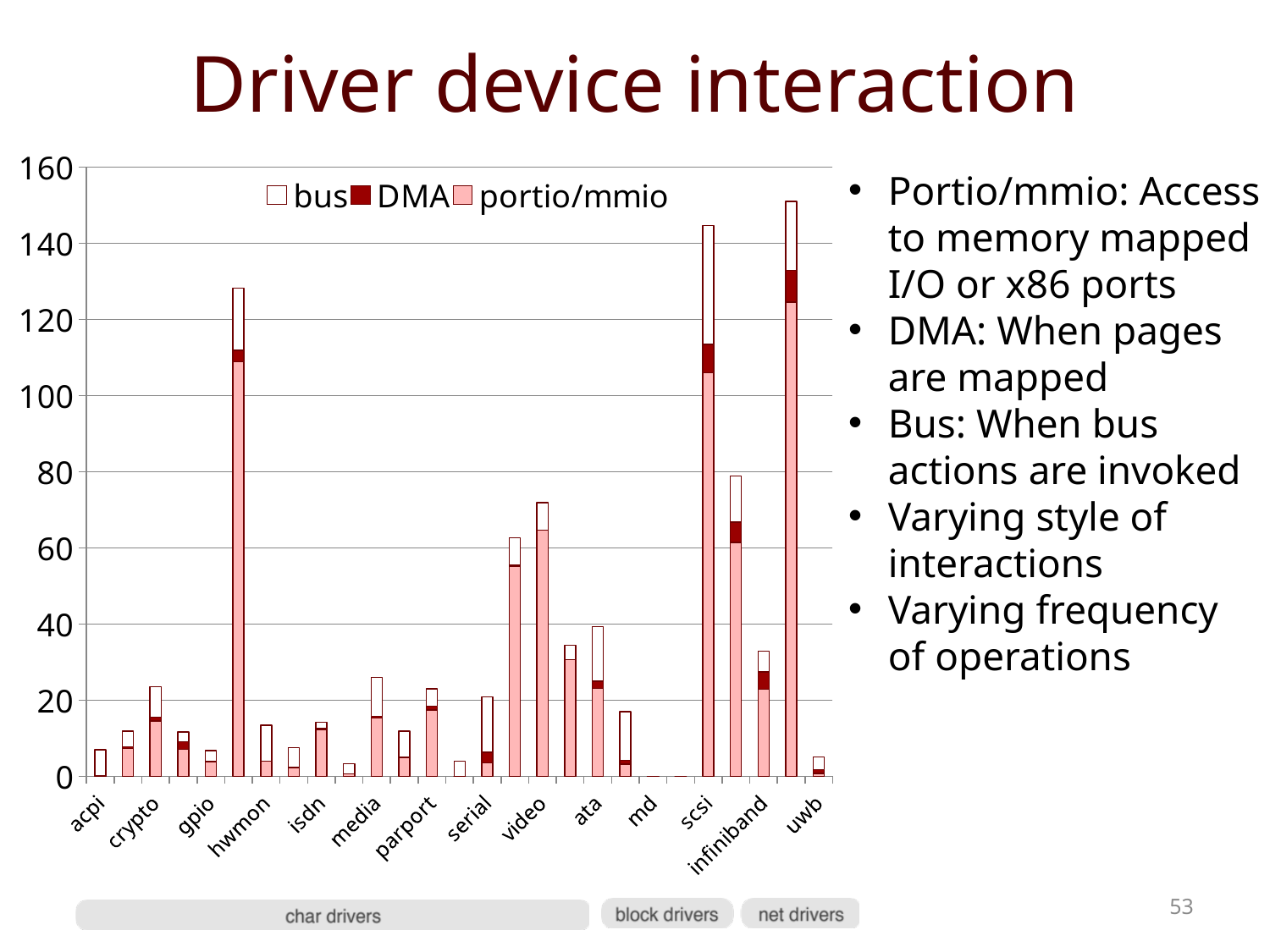
How many series does the legend list? 3 Which has the larger total, scsi or md? scsi Is the total value for acpi greater or less than 20? less How many category labels are shown along the x axis? 14 What are the three series named in the legend? bus, DMA, portio/mmio Is the total value for scsi greater or less than 100? greater Which has the larger total, video or acpi? video What kind of chart is shown on the slide? stacked bar chart Which series is drawn in dark red? DMA Is the total value for md greater or less than 20? less